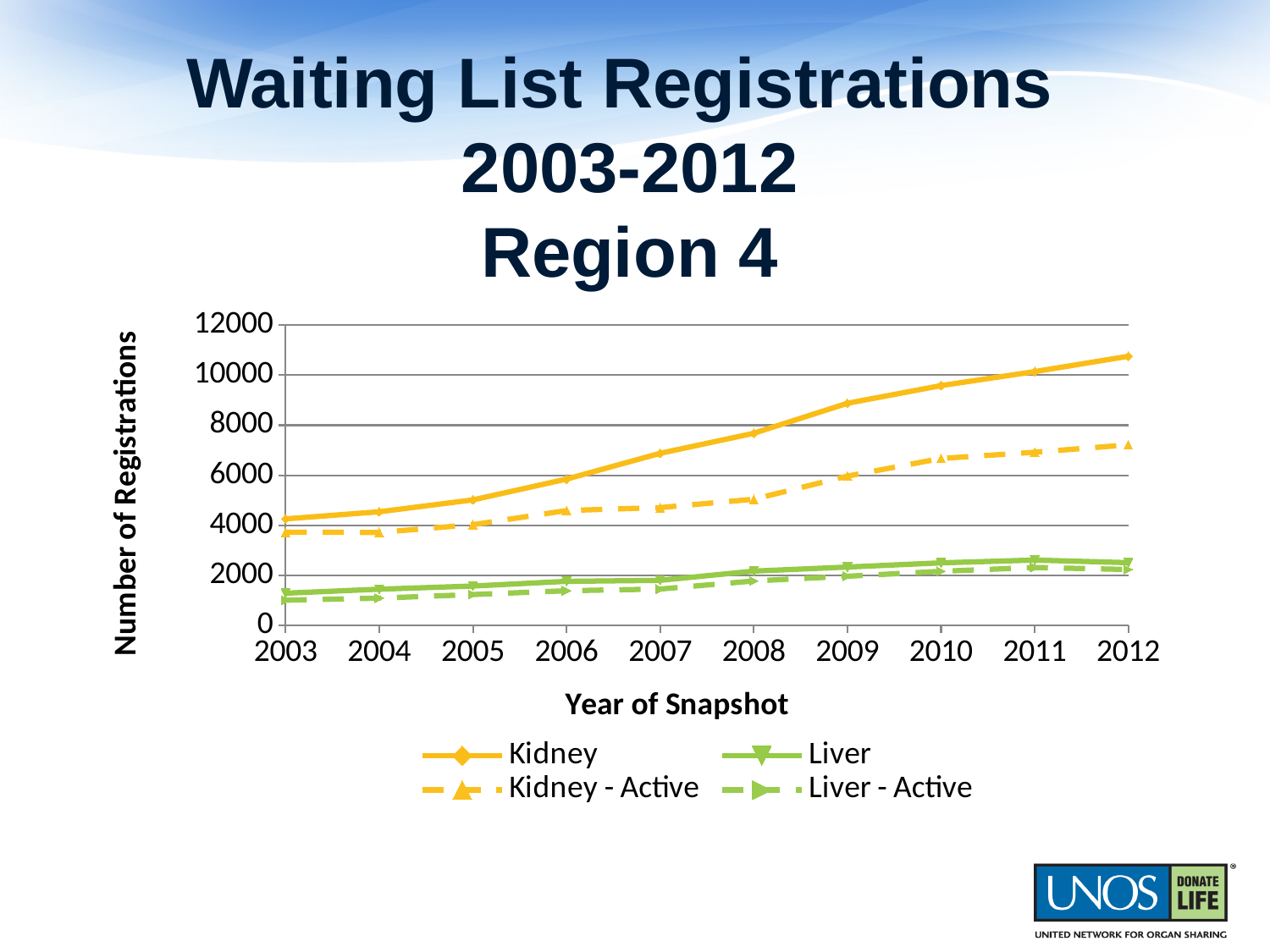
How many years are plotted along the x axis? 10 How many series does the legend list? 4 Is the value for Liver - Active in 2003 greater or less than 2000? less Is the value for Kidney - Active in 2012 greater or less than 6000? greater In which year is the Kidney series at its lowest? 2003 In which year is the Kidney series at its highest? 2012 Is the value for Kidney in 2009 greater or less than 8000? greater What kind of chart is shown on the slide? line chart In 2012, which series has the larger value, Kidney or Liver? Kidney What is the label of the y axis? Number of Registrations Do the Kidney registrations rise or fall from 2003 to 2012? rise